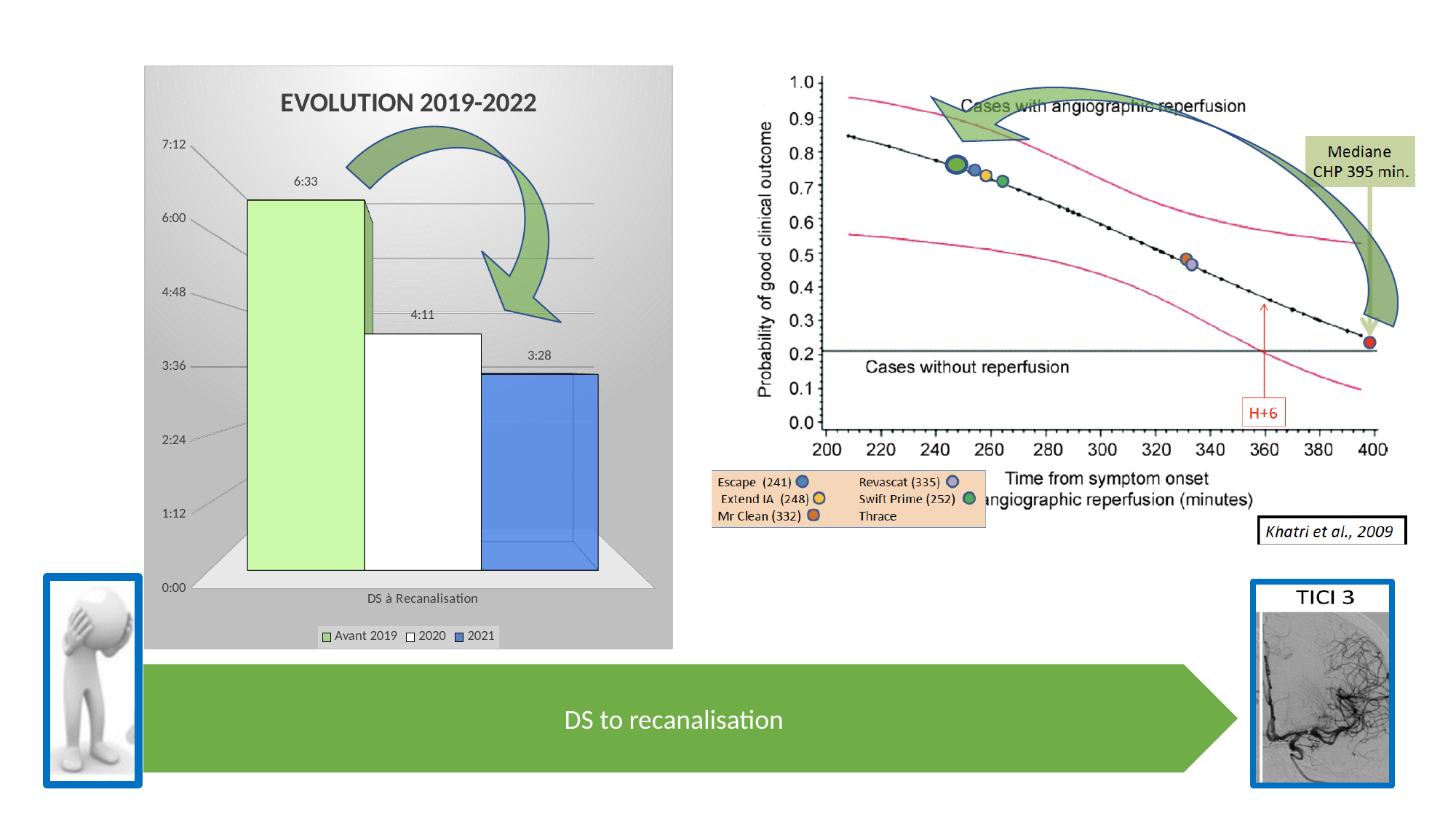
In the EVOLUTION 2019-2022 bar chart, what is the value for Avant 2019? 6:33 In the EVOLUTION 2019-2022 bar chart, which series has the highest value? Avant 2019 In the EVOLUTION 2019-2022 bar chart, do the values rise or fall from Avant 2019 to 2021? fall In the EVOLUTION 2019-2022 bar chart, what is the value for 2020? 4:11 In the chart on the right (Khatri et al., 2009), what is the median time for CHP given in the annotation? 395 min. In the EVOLUTION 2019-2022 bar chart, is the value for 2020 larger or smaller than the value for 2021? larger In the EVOLUTION 2019-2022 bar chart, what is the value for 2021? 3:28 In the chart on the right (Khatri et al., 2009), is the probability of good clinical outcome at the CHP median point (red dot near 400 minutes) greater or less than 0.3? less In the EVOLUTION 2019-2022 bar chart, which series has the lowest value? 2021 What kind of chart is the EVOLUTION 2019-2022 chart on the left? bar chart In the chart on the right (Khatri et al., 2009), what time value is listed for Mr Clean in the legend? 332 In the EVOLUTION 2019-2022 bar chart, how many series does the legend list? 3